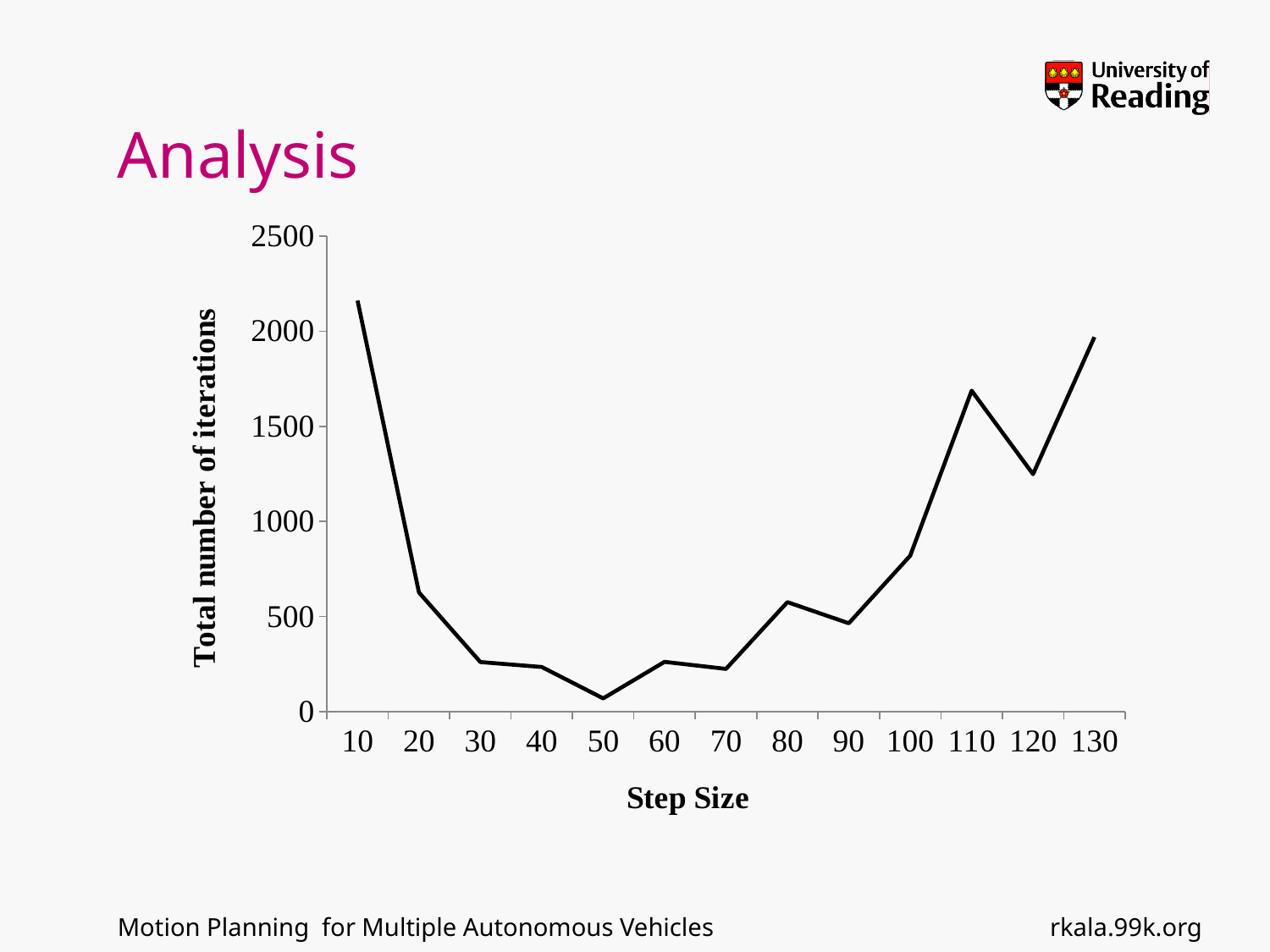
At which step size is the total number of iterations highest? 10 How many step size values are plotted on the x axis? 13 Is the total number of iterations at step size 100 greater or less than 1000? less Is the total number of iterations at step size 50 greater or less than 500? less Is the total number of iterations at step size 110 greater or less than 1500? greater Does the total number of iterations rise or fall as the step size increases from 10 to 50? fall Which has more total iterations: step size 110 or step size 120? 110 What is the label of the y axis? Total number of iterations At which step size is the total number of iterations lowest? 50 What kind of chart is shown on the slide? line chart